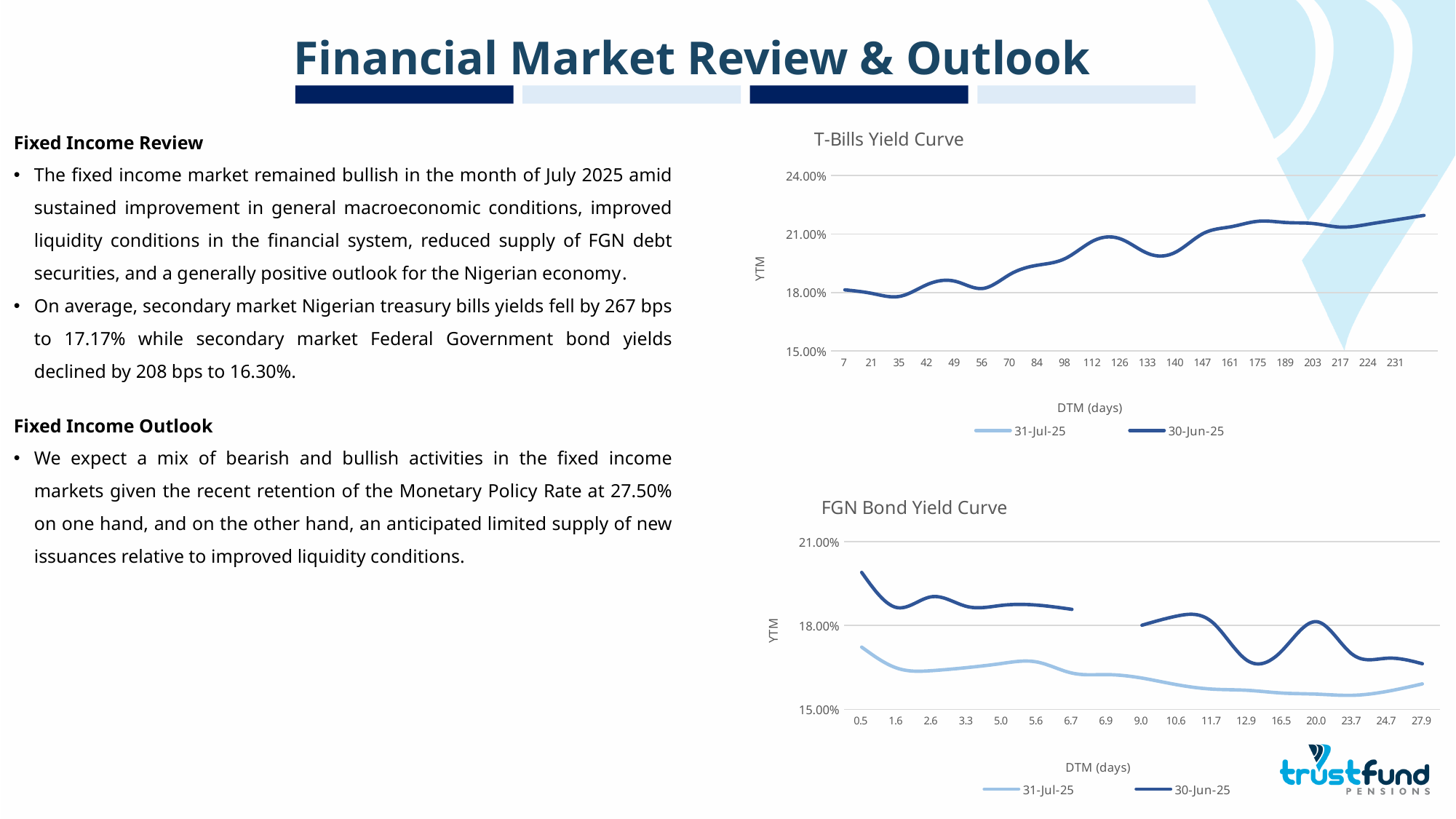
In the FGN Bond Yield Curve chart, is the 31-Jul-25 value at 27.9 days greater or less than 18.00%? less How many series does the legend of the FGN Bond Yield Curve chart list? 2 How many series does the legend of the T-Bills Yield Curve chart list? 2 How many DTM (days) tick labels are shown on the x axis of the FGN Bond Yield Curve chart? 17 In the FGN Bond Yield Curve chart, which series has the higher value at 0.5 days, 31-Jul-25 or 30-Jun-25? 30-Jun-25 What is the label on the y axis of the T-Bills Yield Curve chart? YTM In the T-Bills Yield Curve chart, is the 30-Jun-25 value at 231 days greater or less than 21.00%? greater In the FGN Bond Yield Curve chart, is the 30-Jun-25 value at 0.5 days greater or less than 18.00%? greater How many DTM (days) tick labels are shown on the x axis of the T-Bills Yield Curve chart? 21 In the T-Bills Yield Curve chart, does the 30-Jun-25 line generally rise or fall as DTM increases? rise What kind of chart is the T-Bills Yield Curve chart? line chart